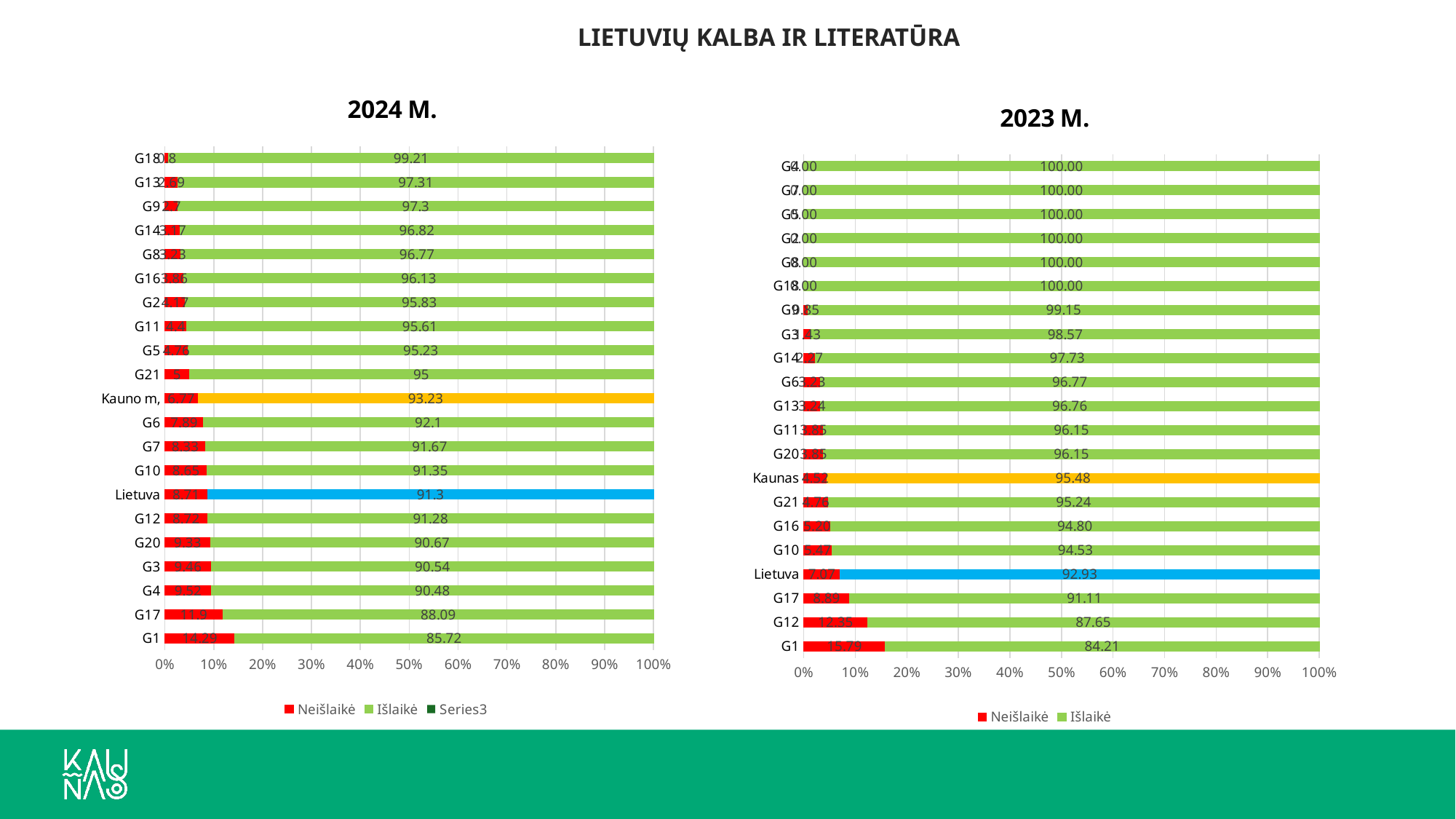
In the 2024 M. chart, what is the difference between the Išlaikė values of G18 and G1? 13.49 In the 2024 M. chart, how many entries does the legend list? 3 In the 2024 M. chart, what is the Išlaikė value for G18? 99.21 In the 2023 M. chart, what is the Neišlaikė value for G12? 12.35 In the 2023 M. chart, how many categories are plotted? 21 What kind of chart is the 2023 M. chart? Stacked bar chart In the 2023 M. chart, is the Išlaikė value for Lietuva larger or smaller than that for Kaunas? smaller In the 2023 M. chart, which category has the lowest Išlaikė value? G1 In the 2024 M. chart, which category has the lowest Išlaikė value? G1 In the 2024 M. chart, what is the Išlaikė value for Kauno m.? 93.23 In the 2024 M. chart, what is the Neišlaikė value for G1? 14.29 In the 2023 M. chart, what is the Išlaikė value for Kaunas? 95.48